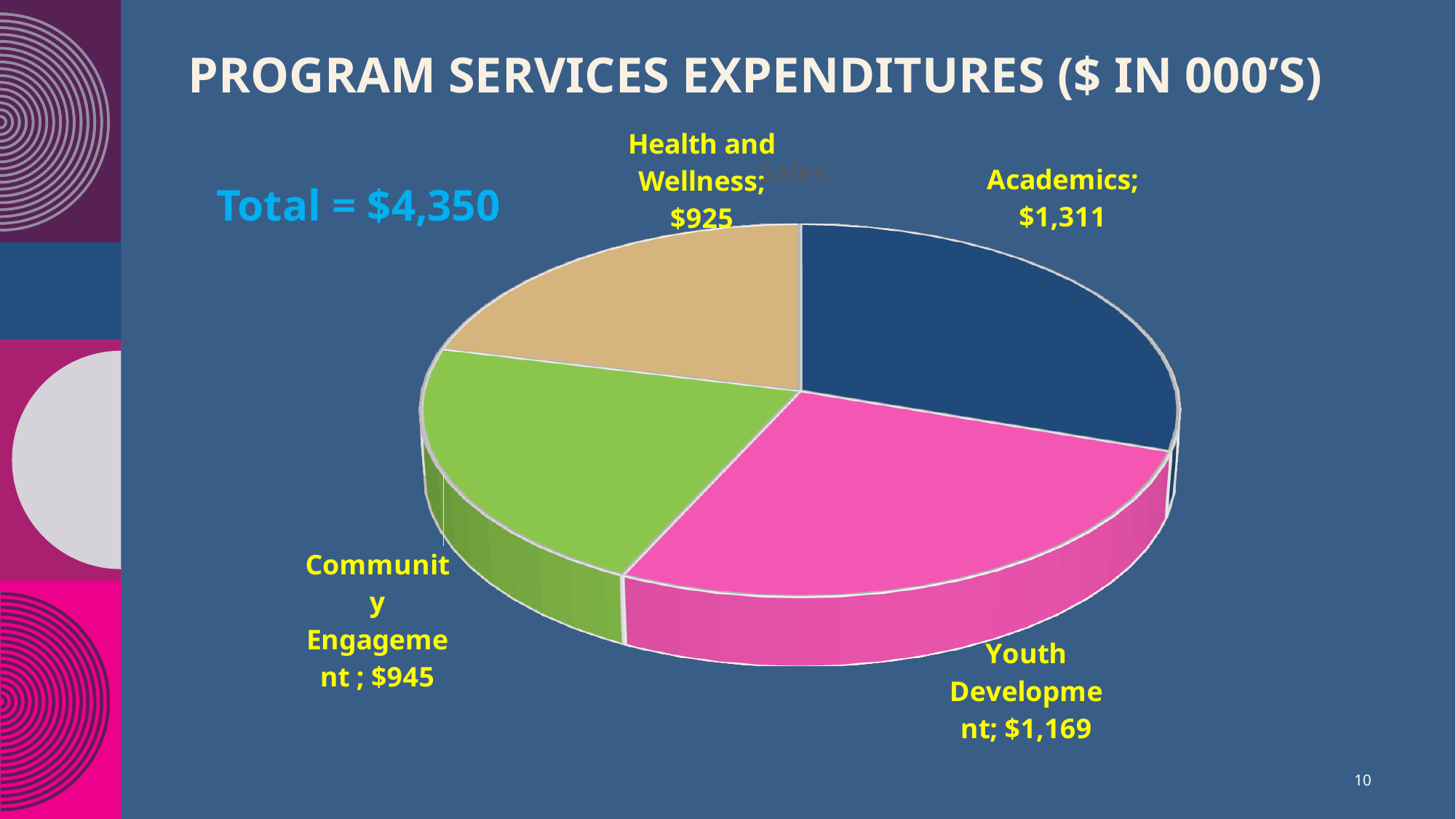
What is the expenditure for Health and Wellness? $925 What is the expenditure for Academics? $1,311 What is the difference between the Academics and Youth Development expenditures? $142 What total expenditure is stated on the slide? $4,350 Which program service has the highest expenditure? Academics How many slices does the pie chart have? 4 What is the expenditure for Youth Development? $1,169 What is the title of the slide? PROGRAM SERVICES EXPENDITURES ($ IN 000'S) Which is larger, the expenditure for Community Engagement or for Health and Wellness? Community Engagement What is the expenditure for Community Engagement? $945 What type of chart is shown on the slide? Pie chart Which program service has the lowest expenditure? Health and Wellness